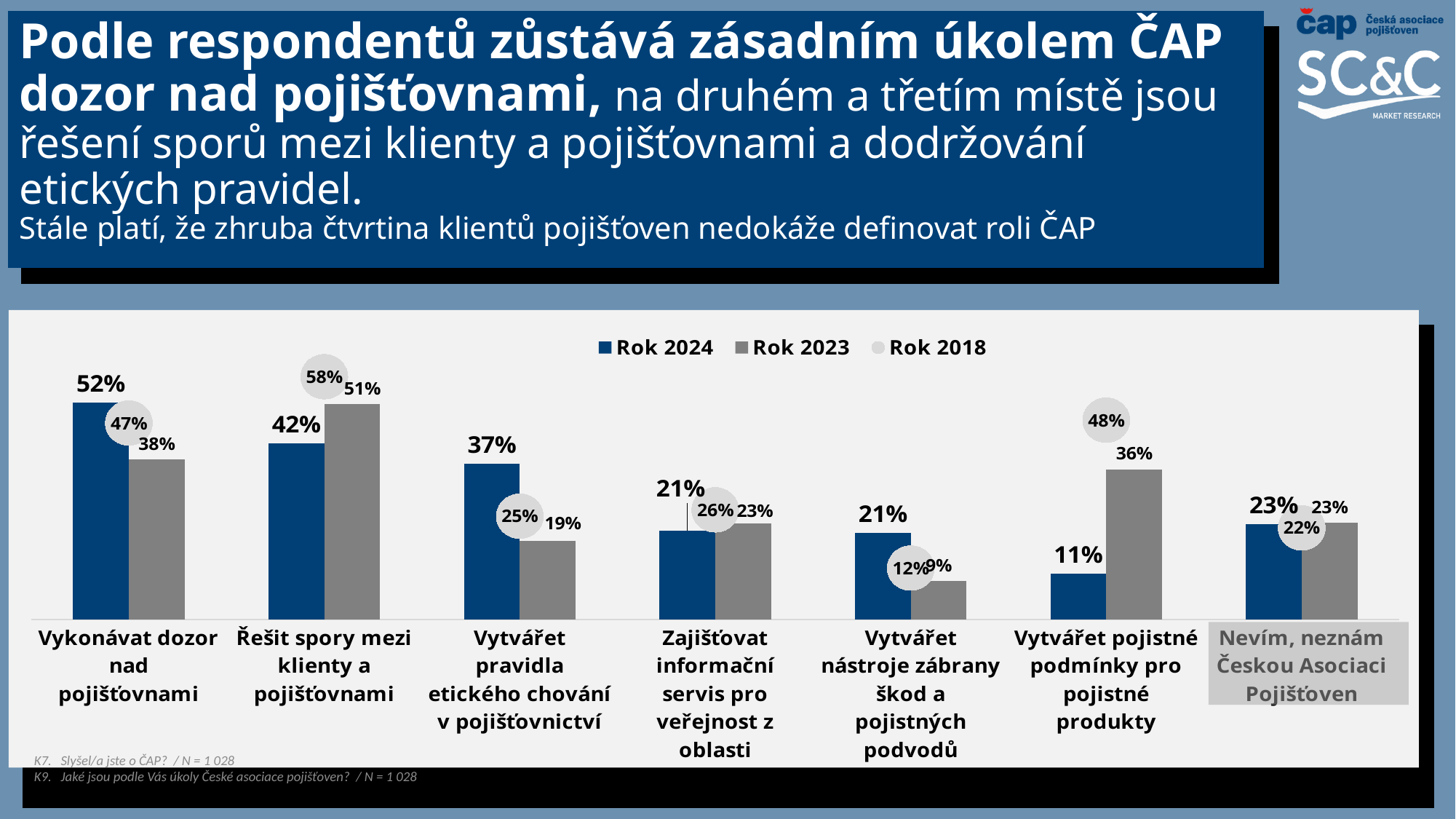
Which category has the lowest Rok 2024 value? Vytvářet pojistné podmínky pro pojistné produkty Which category has the highest Rok 2024 value? Vykonávat dozor nad pojišťovnami How many series does the legend list? 3 What is the Rok 2024 value for "Vykonávat dozor nad pojišťovnami"? 52% What kind of chart is shown on the slide? Bar chart How many categories are shown on the x axis of the chart? 7 For "Řešit spory mezi klienty a pojišťovnami", which is larger: the Rok 2024 value or the Rok 2023 value? Rok 2023 What is the Rok 2018 value for "Řešit spory mezi klienty a pojišťovnami"? 58% What is the Rok 2023 value for "Vytvářet pojistné podmínky pro pojistné produkty"? 36% What is the difference between the Rok 2024 and Rok 2023 values for "Vykonávat dozor nad pojišťovnami"? 14 percentage points What is the Rok 2023 value for "Vytvářet nástroje zábrany škod a pojistných podvodů"? 9% What is the difference between the Rok 2018 and Rok 2024 values for "Vytvářet pojistné podmínky pro pojistné produkty"? 37 percentage points